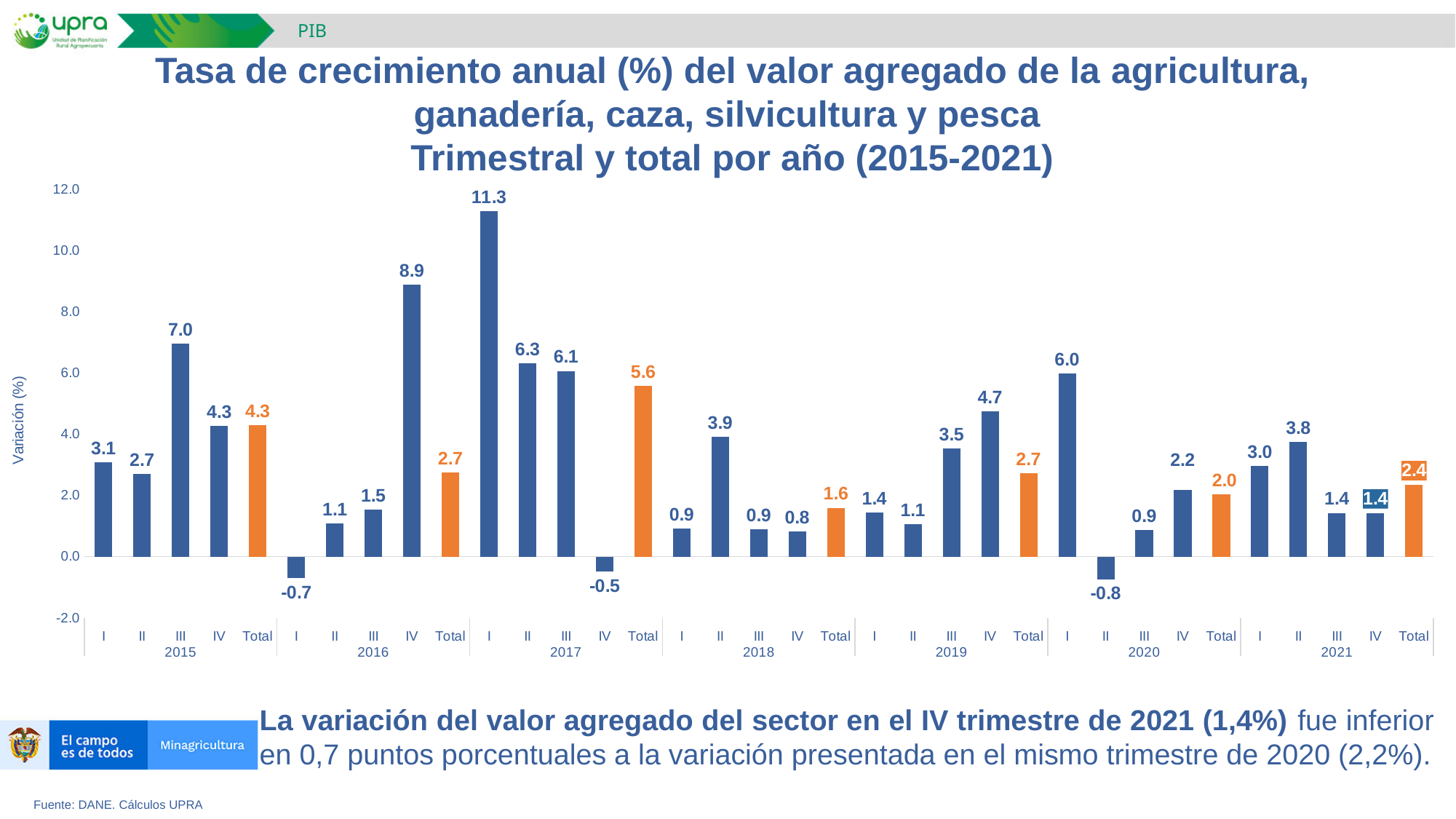
What is the value of the Total bar for 2017? 5.6 What colour are the Total bars for each year? Orange Do the quarterly values for 2021 rise or fall from quarter II to quarter IV? Fall What is the value for the second quarter (II) of 2020? -0.8 How many bars are plotted on the chart in total? 35 Which bar has the lowest value on the chart? II 2020 What is the growth rate shown for the fourth quarter (IV) of 2016? 8.9 What is the annual growth rate for the first quarter (I) of 2017? 11.3 Which bar has the highest value on the chart? I 2017 What is the difference between the value for IV 2020 (2.2) and IV 2021 (1.4)? 0.8 What kind of chart is shown on the slide? Bar chart Which is larger: the Total for 2015 or the Total for 2018? Total 2015